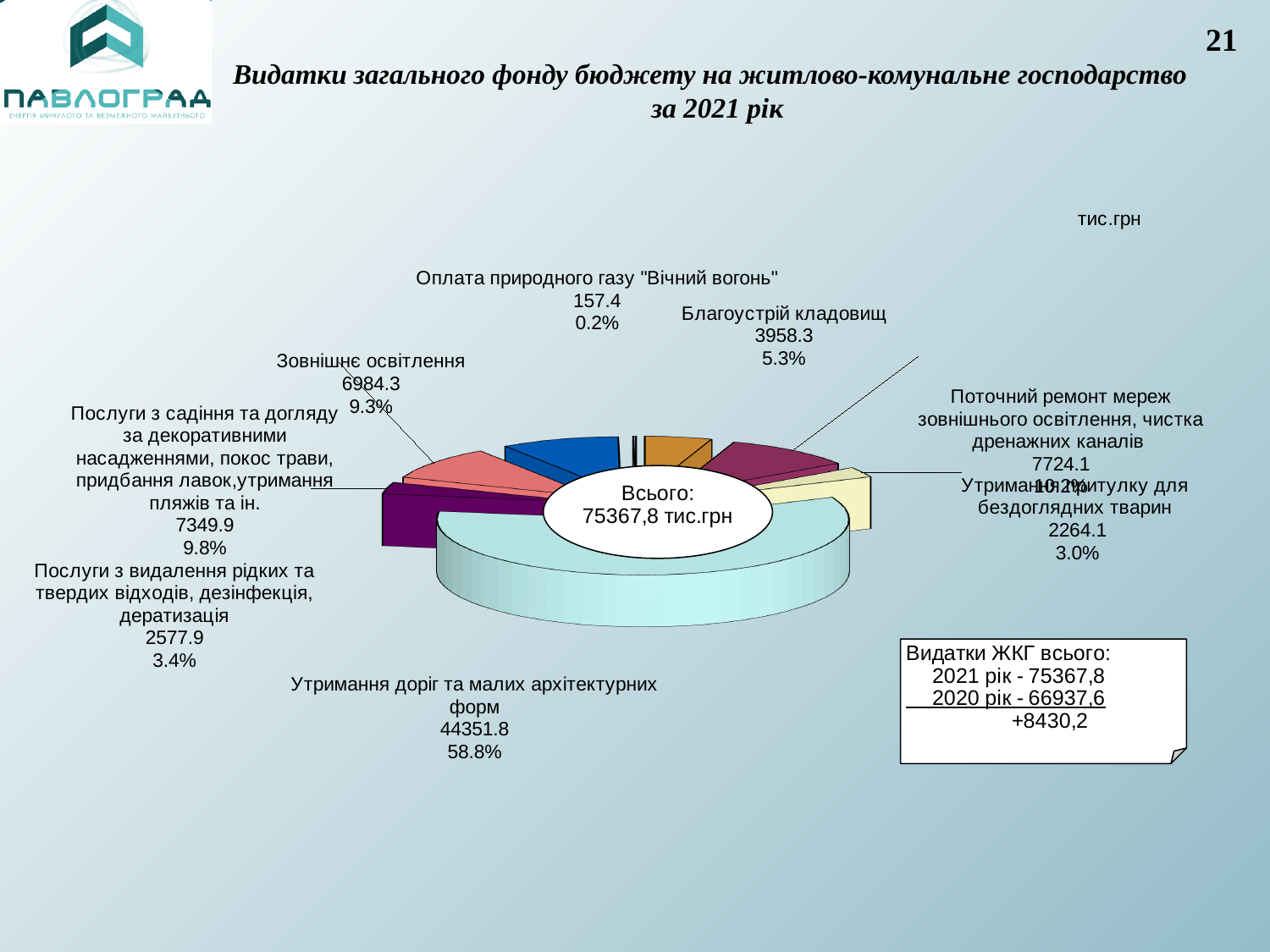
Which category has the largest value in the pie chart? Утримання доріг та малих архітектурних форм How many categories does the pie chart show? 8 What unit is indicated for the values in the chart? тис.грн What share of the pie does Утримання притулку для бездоглядних тварин represent? 3.0% What is the value for Благоустрій кладовищ? 3958.3 What total is shown in the centre of the pie chart? 75367,8 тис.грн Which is larger: the value for Благоустрій кладовищ or the value for Послуги з видалення рідких та твердих відходів, дезінфекція, дератизація? Благоустрій кладовищ What share of the pie does Утримання доріг та малих архітектурних форм represent? 58.8% What kind of chart is shown on the slide? pie chart Which category has the smallest value in the pie chart? Оплата природного газу "Вічний вогонь" What is the difference between the values for Послуги з садіння та догляду за декоративними насадженнями and Зовнішнє освітлення? 365.6 What is the value for Зовнішнє освітлення? 6984.3